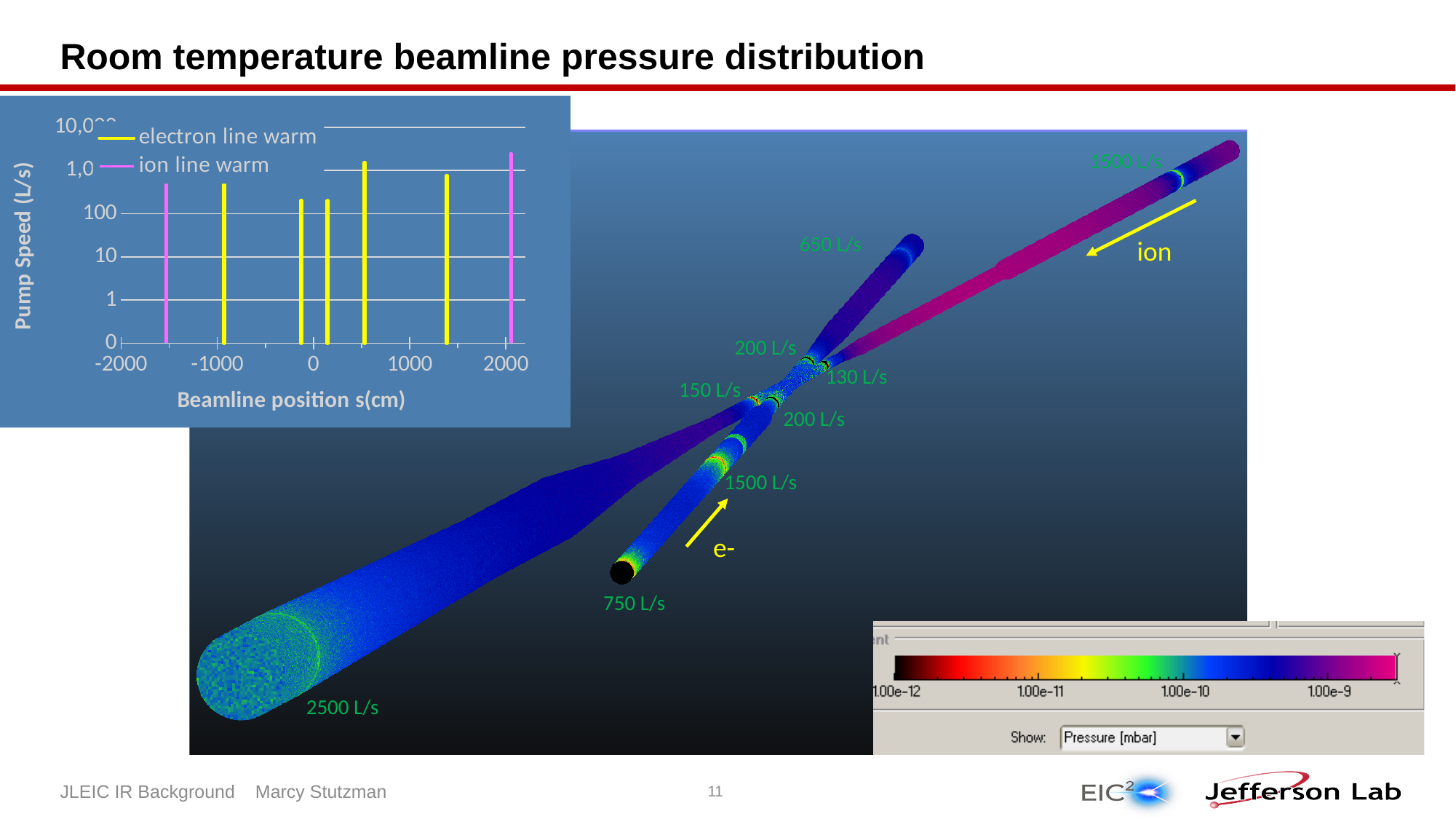
What are the two series named in the chart legend? electron line warm, ion line warm How many bars belong to the ion line warm series? 2 How many bars are plotted in the chart in total? 7 Is the pump speed of the electron line warm bar near 1400 cm greater or less than 1,000 L/s? less Is the pump speed of the ion line warm bar near -1500 cm greater or less than 100 L/s? greater Is the pump speed of the electron line warm bar near 500 cm greater or less than 1,000 L/s? greater Which bar has the highest pump speed in the chart? the ion line warm bar near 2000 cm Which has the higher pump speed: the electron line warm bar near 500 cm or the one near 1400 cm? the bar near 500 cm What kind of chart is shown on the slide? bar chart How many bars belong to the electron line warm series? 5 What is the x-axis title of the chart? Beamline position s(cm) How many series does the chart legend list? 2